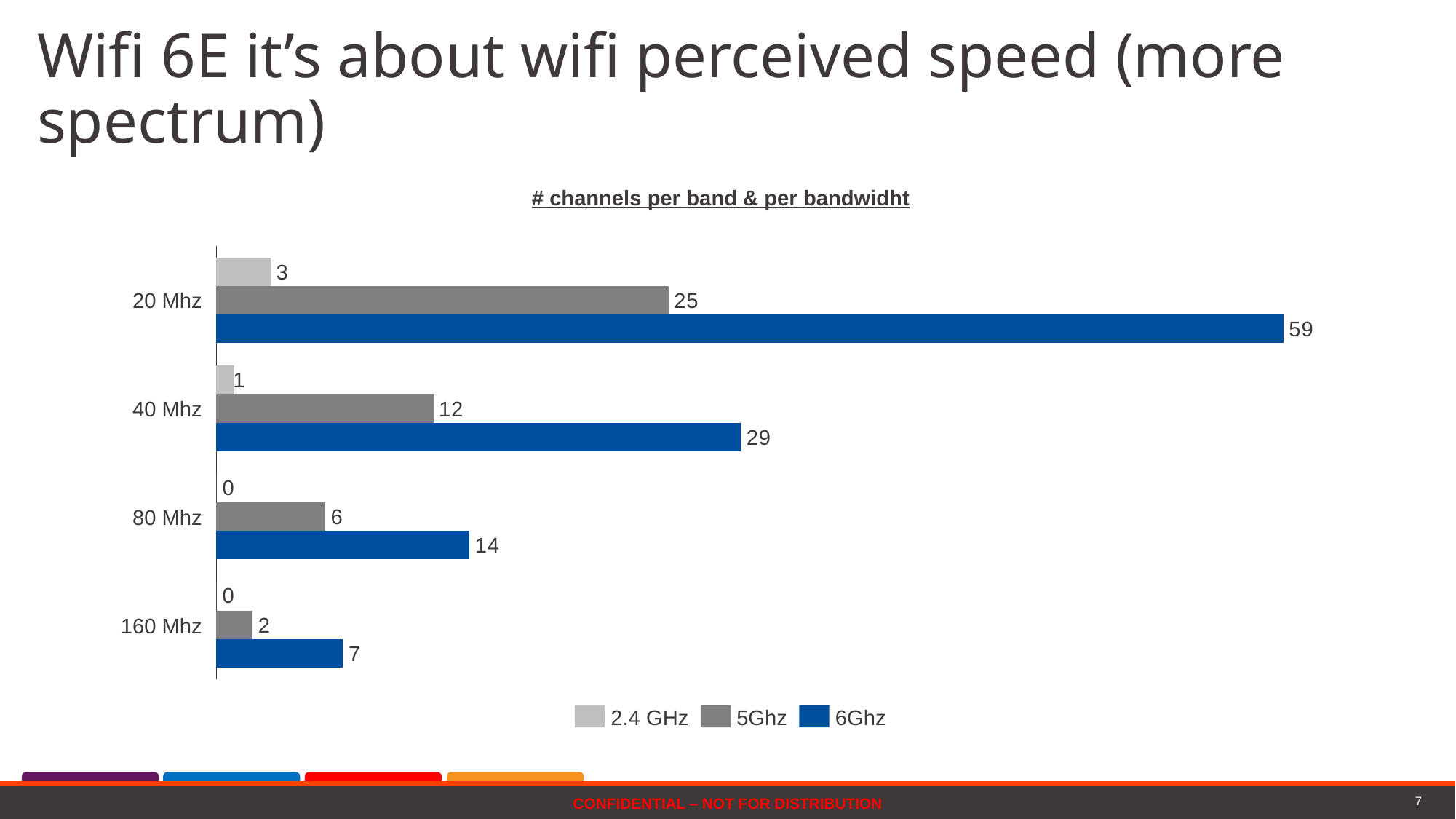
What is the number of 5Ghz channels at 40 Mhz bandwidth? 12 Do the 6Ghz channel counts rise or fall as bandwidth increases from 20 Mhz to 160 Mhz? Fall What is the difference between the 6Ghz and 5Ghz channel counts at 20 Mhz? 34 Which bandwidth has the highest number of 6Ghz channels? 20 Mhz How many series does the legend list? 3 Which bandwidth has the lowest number of 5Ghz channels? 160 Mhz What is the number of 6Ghz channels at 20 Mhz bandwidth? 59 How many bandwidth categories are shown on the chart? 4 Which is larger: the 6Ghz channel count at 40 Mhz or the 5Ghz channel count at 20 Mhz? 6Ghz at 40 Mhz What is the number of 2.4 GHz channels at 80 Mhz bandwidth? 0 What kind of chart is shown on the slide? Bar chart What is the title of the chart? # channels per band & per bandwidht